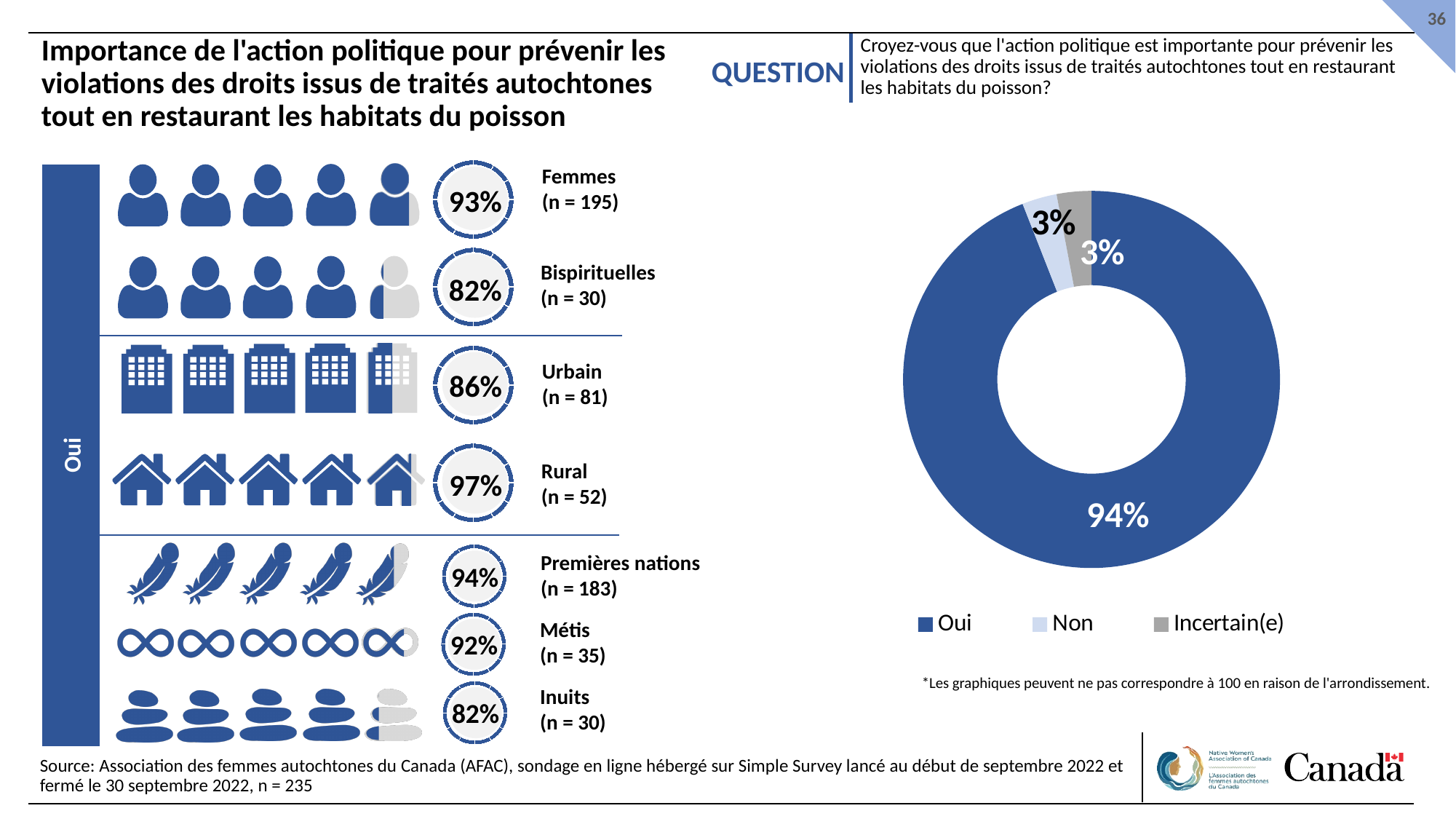
In the donut chart on the right, what is the difference in percentage points between "Oui" and "Non"? 91 percentage points In the donut chart on the right, what percentage answered "Oui"? 94% In the infographic on the left, which has a higher "Oui" percentage: Urbain or Rural? Rural How many groups are shown in the infographic on the left? 7 In the infographic on the left, what percentage of Femmes (n = 195) answered "Oui"? 93% In the donut chart on the right, which response has the largest share? Oui In the donut chart on the right, what percentage answered "Non"? 3% In the infographic on the left, which group has the highest percentage answering "Oui"? Rural In the donut chart on the right, what percentage answered "Incertain(e)"? 3% How many entries does the legend of the donut chart on the right list? 3 What kind of chart is shown on the right side of the slide? Donut (pie) chart In the infographic on the left, what percentage of Rural respondents (n = 52) answered "Oui"? 97%